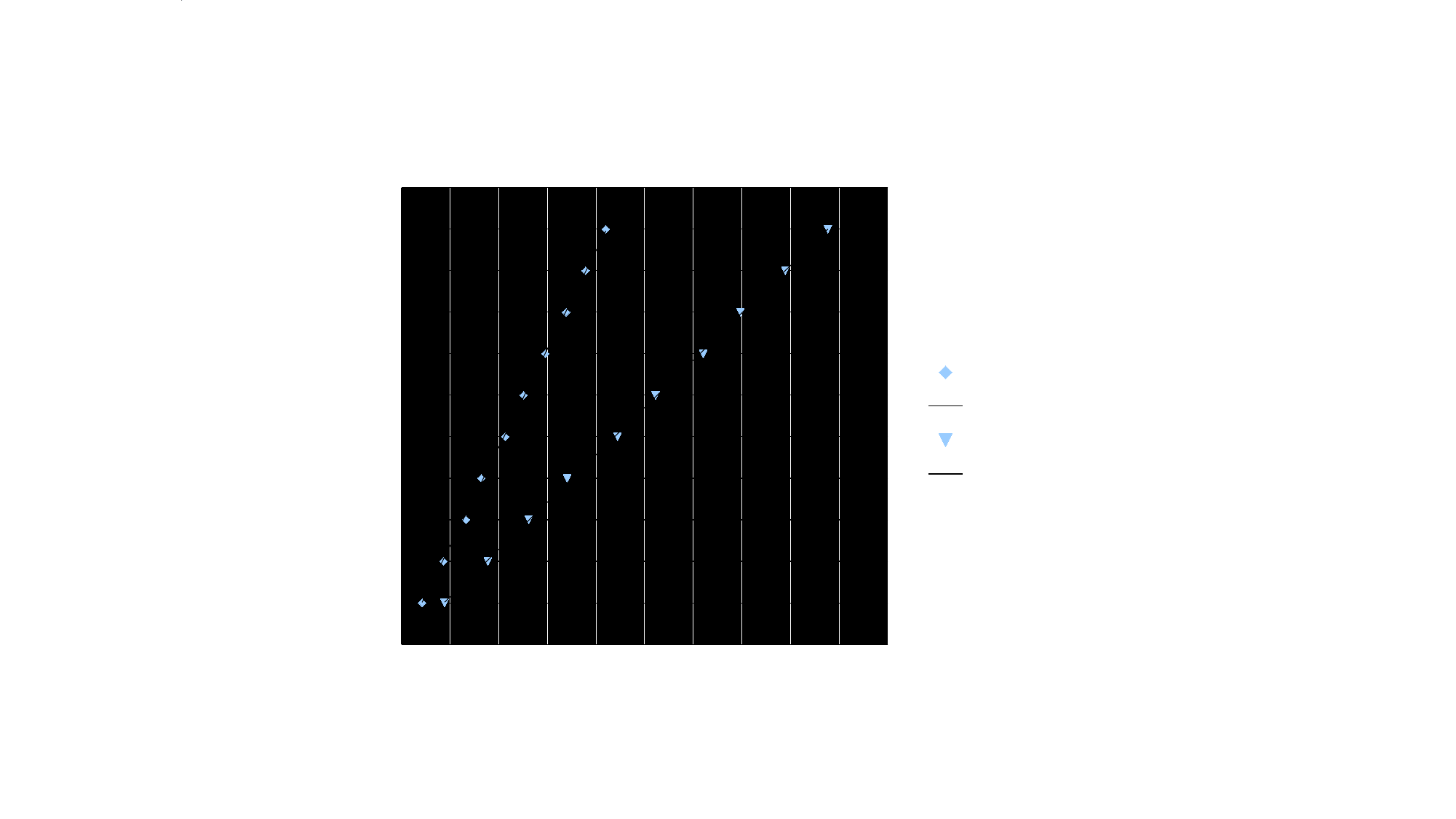
How many series does the legend list? 2 How many points are plotted in the diamond-marker series? 10 How many points are plotted in the triangle-marker series? 10 What marker shape is used for the first series in the legend? diamond Do the values of the triangle-marker series rise or fall as you move right along the x axis? rise What kind of chart is shown on the slide? scatter chart Do the values of the diamond-marker series rise or fall as you move right along the x axis? rise What colour are the plotted markers? light blue